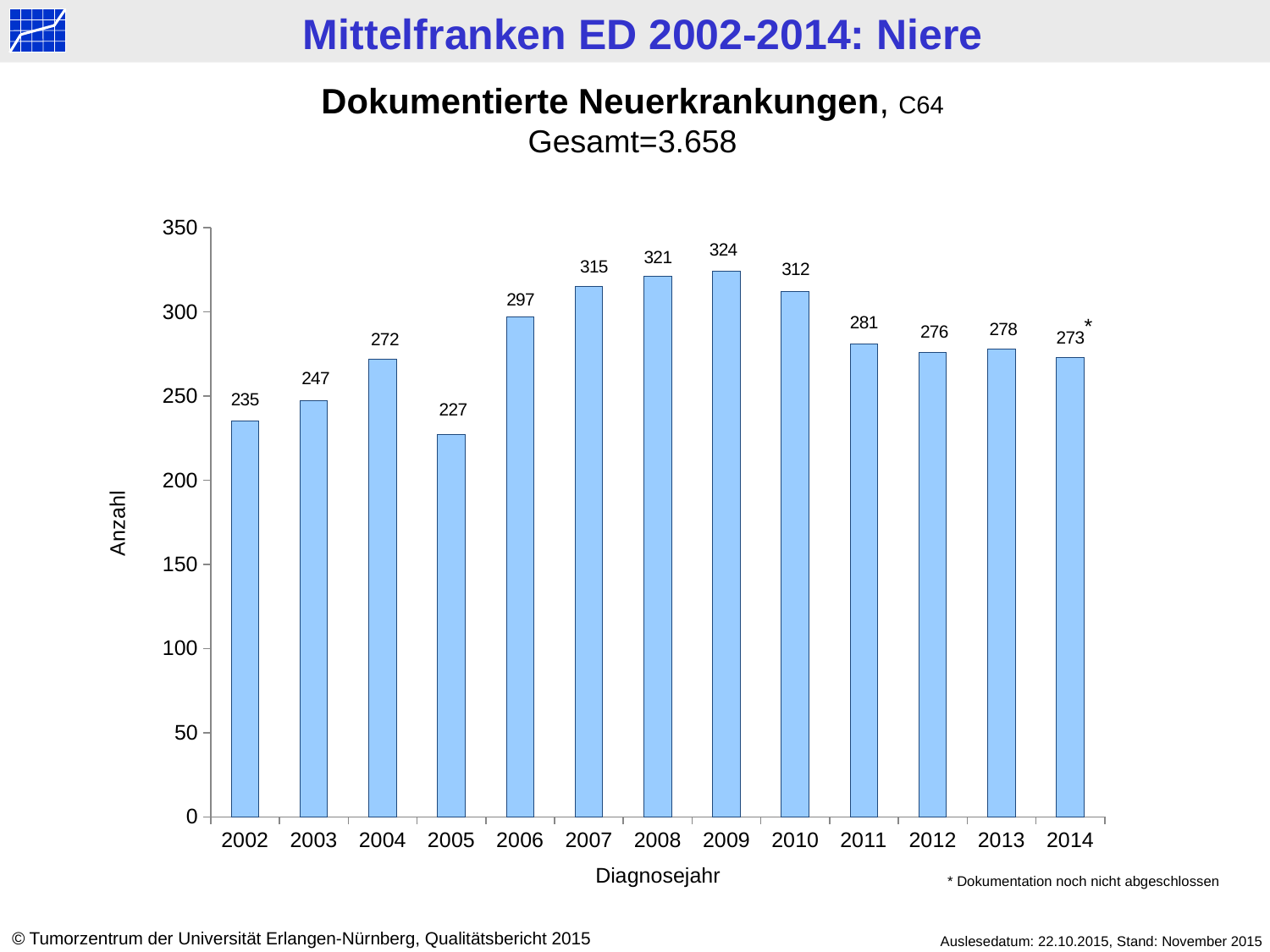
What total (Gesamt) is stated above the chart? 3.658 Do the values rise or fall from 2009 to 2014? fall What is the value for 2014? 273 How many years are shown on the x axis? 13 What is the value for 2005? 227 Which year has the highest value? 2009 What is the difference between the values for 2009 and 2005? 97 What kind of chart is shown? bar chart Which year has the lowest value? 2005 What is the label of the y axis? Anzahl What is the value for 2009? 324 Which is larger, the value for 2006 or the value for 2010? 2010